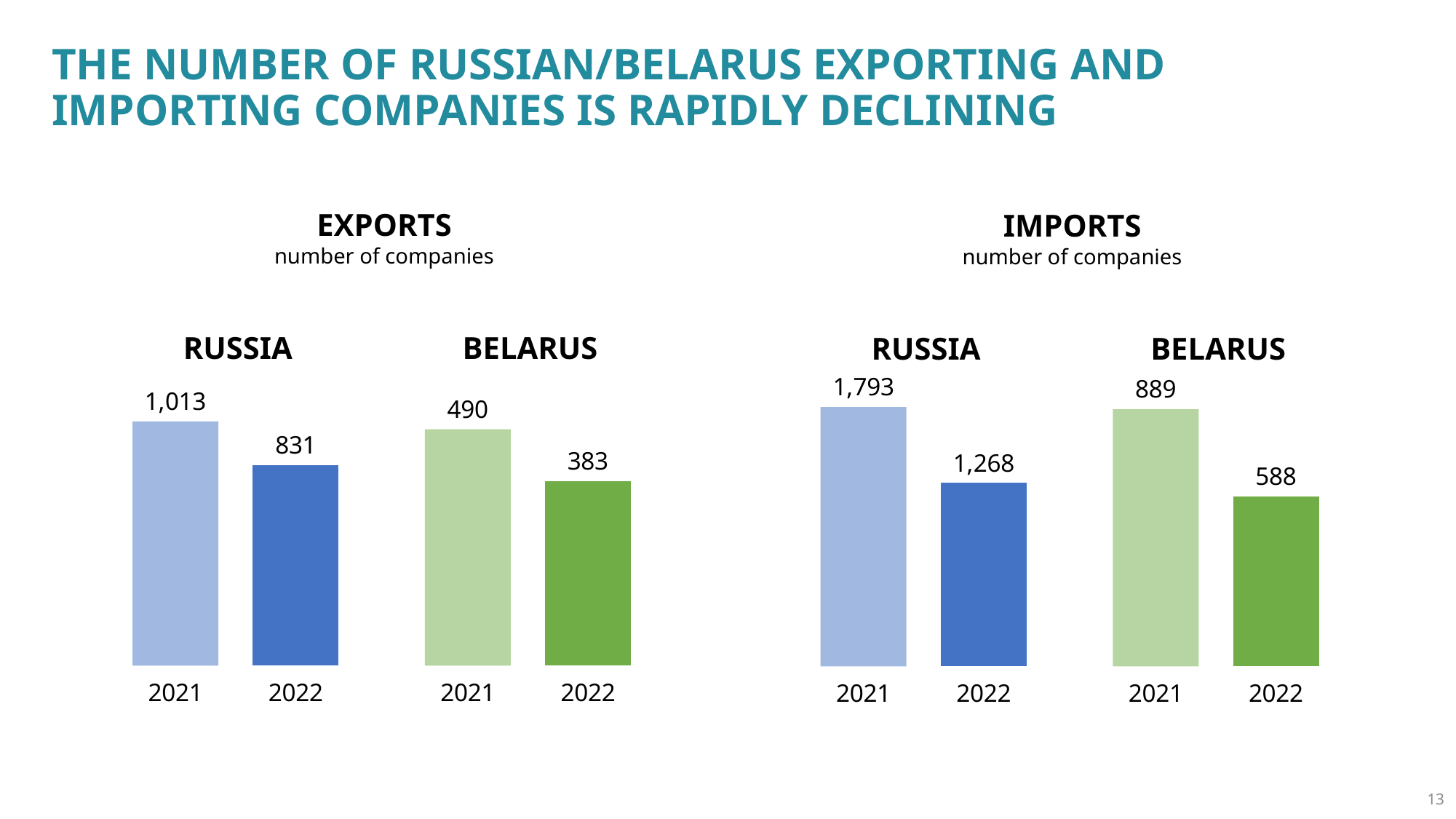
In the EXPORTS chart, by how much did the number of Russian exporting companies fall from 2021 to 2022? 182 In the IMPORTS chart, do the values for Russia rise or fall from 2021 to 2022? fall How many bars are shown in the IMPORTS chart? 4 In the IMPORTS chart, what is the number of Belarus importing companies in 2021? 889 In the EXPORTS chart, which is larger: Russia 2022 or Belarus 2021? Russia 2022 In the IMPORTS chart, which bar is the highest? Russia 2021 What kind of chart is the EXPORTS chart? bar chart In the IMPORTS chart, by how much did the number of Belarus importing companies fall from 2021 to 2022? 301 In the EXPORTS chart, what is the number of Russian exporting companies in 2021? 1,013 In the EXPORTS chart, which bar is the lowest? Belarus 2022 In the IMPORTS chart, what is the number of Russian importing companies in 2022? 1,268 In the EXPORTS chart, what is the number of Belarus exporting companies in 2022? 383